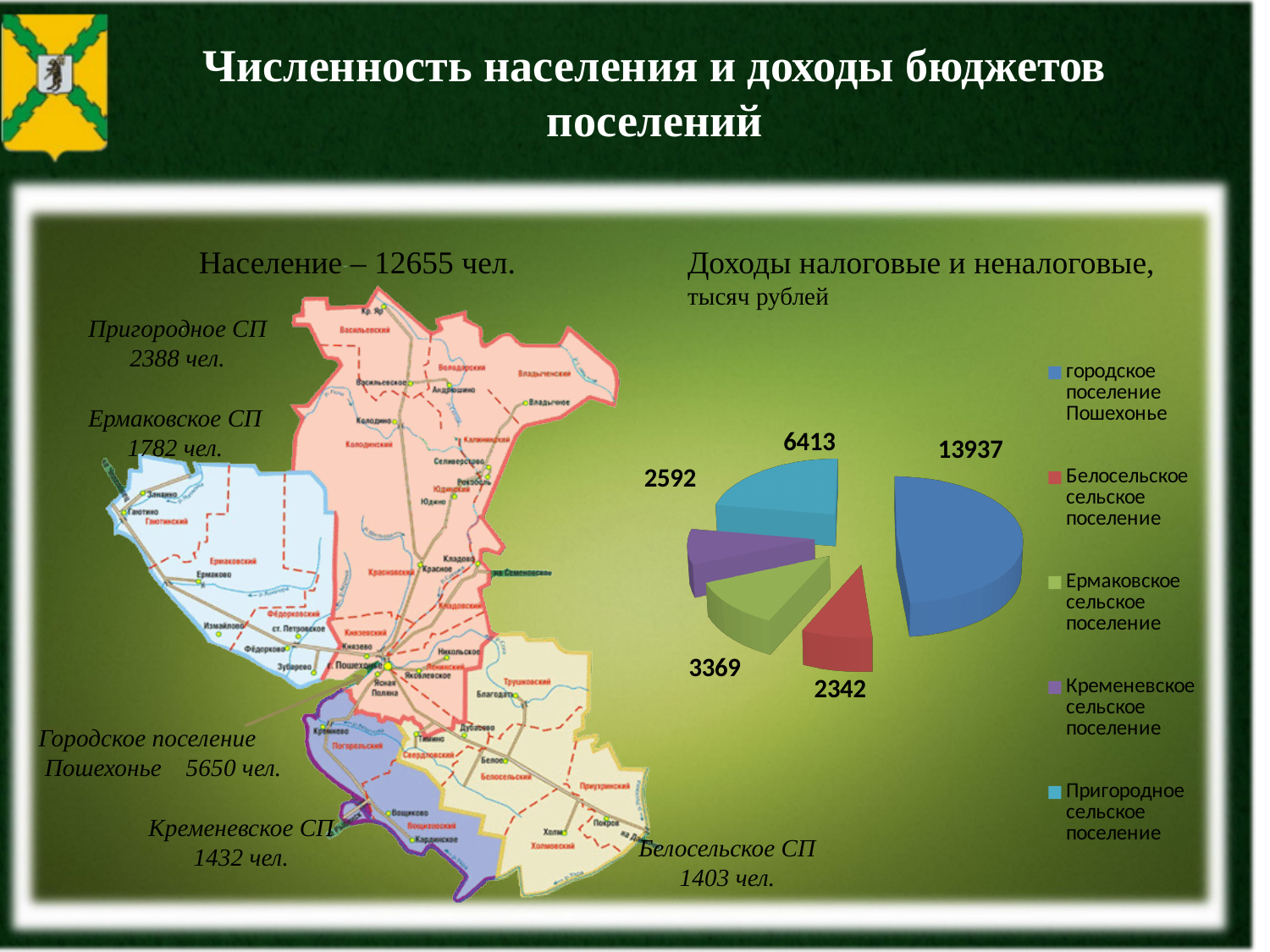
What kind of chart is shown on the slide? pie chart What is the difference between the values for городское поселение Пошехонье and Пригородное сельское поселение in the pie chart? 7524 Which settlement has the smallest slice in the pie chart? Белосельское сельское поселение What colour is the slice for Белосельское сельское поселение in the pie chart? red Which is larger in the pie chart: Ермаковское сельское поселение or Кременевское сельское поселение? Ермаковское сельское поселение Which settlement has the largest slice in the pie chart? городское поселение Пошехонье In the pie chart, what is the value for Пригородное сельское поселение? 6413 In the pie chart, what is the value for Белосельское сельское поселение? 2342 In the pie chart, what is the value for Ермаковское сельское поселение? 3369 How many slices does the pie chart have? 5 In the pie chart, what is the value for Кременевское сельское поселение? 2592 In the pie chart, what is the value for городское поселение Пошехонье? 13937